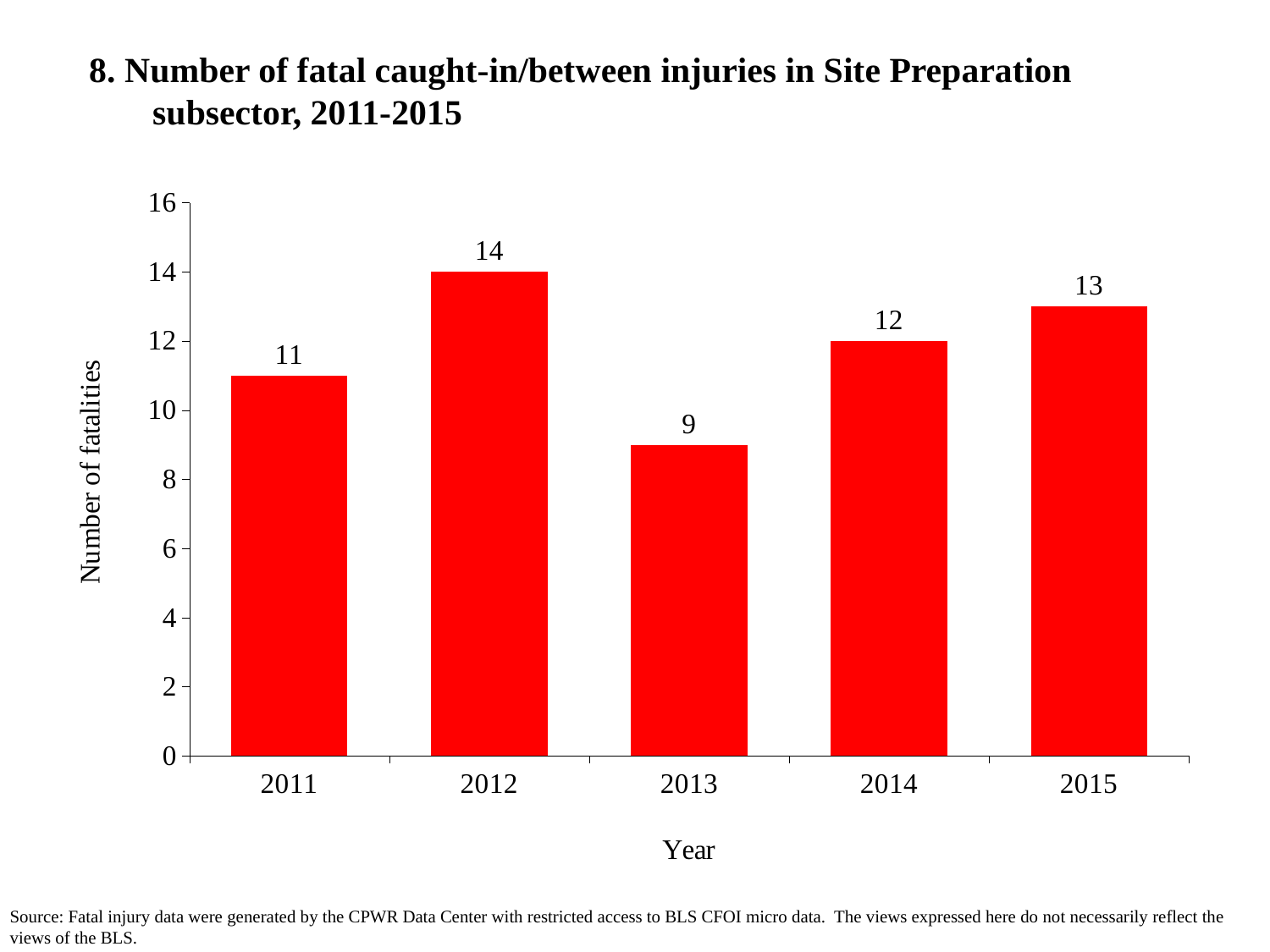
How many years are shown on the x axis? 5 Is the value for 2014 greater or less than 10? greater What kind of chart is shown on the slide? Bar chart How many more fatalities were there in 2015 than in 2011? 2 Which year had the highest number of fatalities? 2012 How many fatal caught-in/between injuries were there in the Site Preparation subsector in 2012? 14 Which year had the lowest number of fatalities? 2013 What is the number of fatalities shown for 2015? 13 What is the label of the y axis? Number of fatalities What is the difference in fatalities between 2012 and 2013? 5 What is the number of fatalities shown for 2013? 9 Which year had more fatalities, 2011 or 2014? 2014